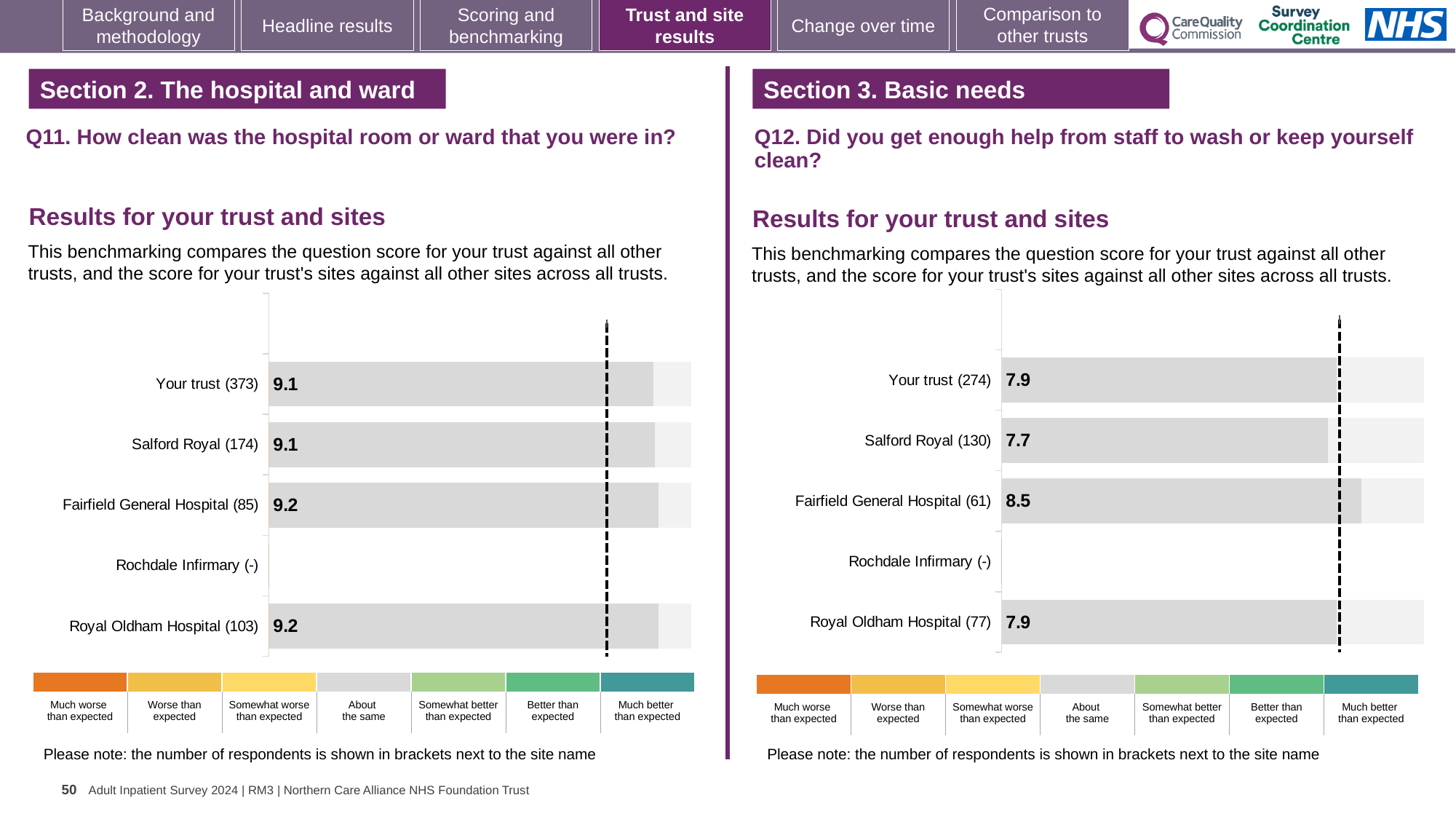
On the Q12 chart (right), what is the score for Fairfield General Hospital (61)? 8.5 How many sites (rows) are listed on the Q11 chart (left)? 5 What kind of chart is used for the Q12 results (right)? Bar chart On the Q11 chart (left), what is the score for Fairfield General Hospital (85)? 9.2 On the Q12 chart (right), what is the difference between the scores for Fairfield General Hospital and Salford Royal? 0.8 On the Q11 chart (left), what is the score for Your trust (373)? 9.1 On the Q11 chart (left), which is larger: the score for Fairfield General Hospital or the score for Salford Royal? Fairfield General Hospital On the Q11 chart (left), what is the score for Royal Oldham Hospital (103)? 9.2 On the Q12 chart (right), what is the score for Salford Royal (130)? 7.7 On the Q12 chart (right), which is larger: the score for Your trust or the score for Salford Royal? Your trust On the Q12 chart (right), which site has the highest score? Fairfield General Hospital (61) On the Q12 chart (right), which site with a score shown has the lowest score? Salford Royal (130)